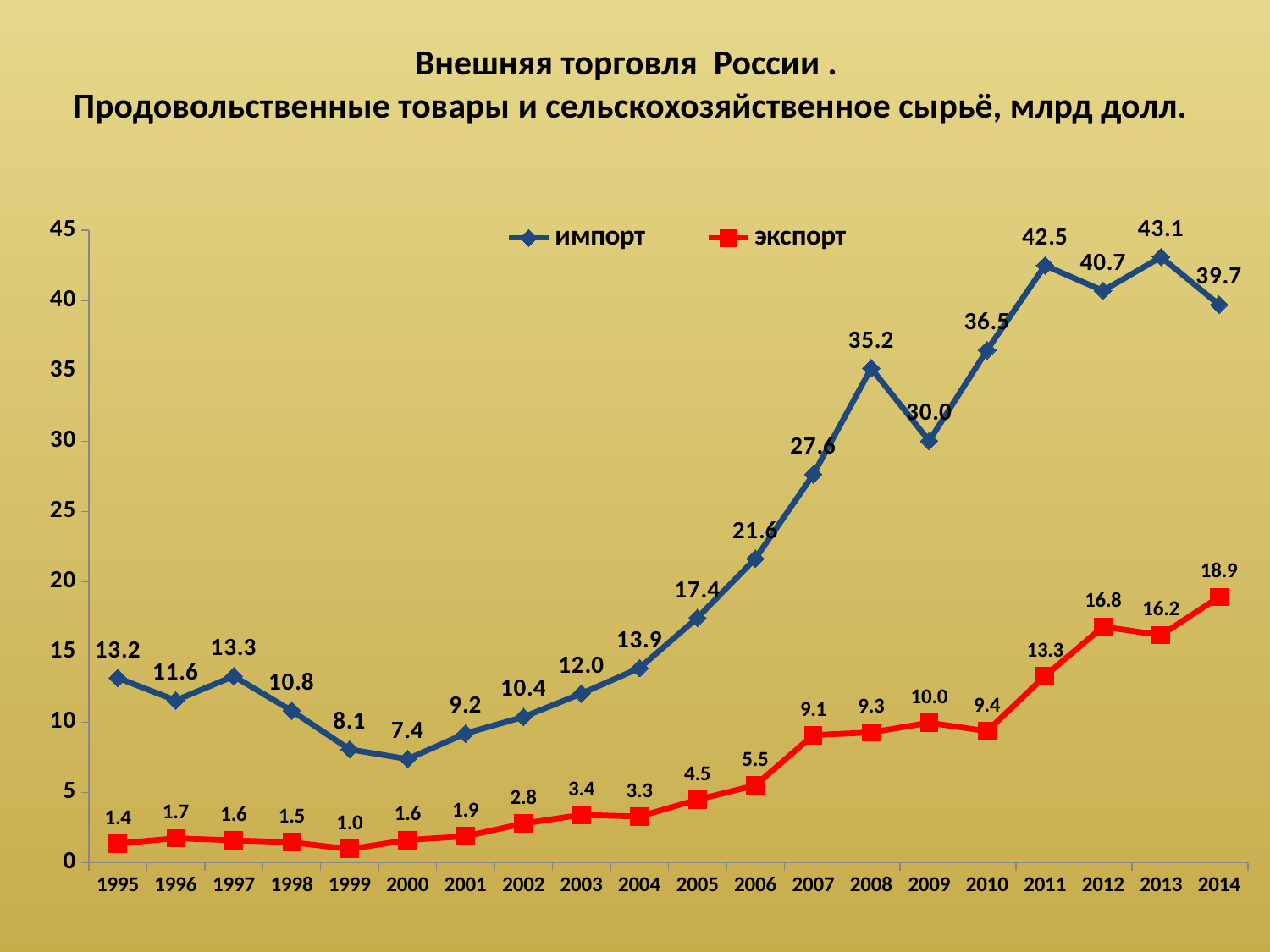
What is the value of импорт in 2000? 7.4 What is the value of импорт in 2008? 35.2 What kind of chart is this? line chart In which year is экспорт lowest? 1999 What is the value of экспорт in 2014? 18.9 Does экспорт rise or fall from 2010 to 2014? rise What colour is the экспорт line? red What is the difference between импорт and экспорт in 2014? 20.8 In which year is импорт highest? 2013 Which is larger in 2009: импорт or экспорт? импорт How many years are shown on the x axis? 20 How many series does the legend list? 2